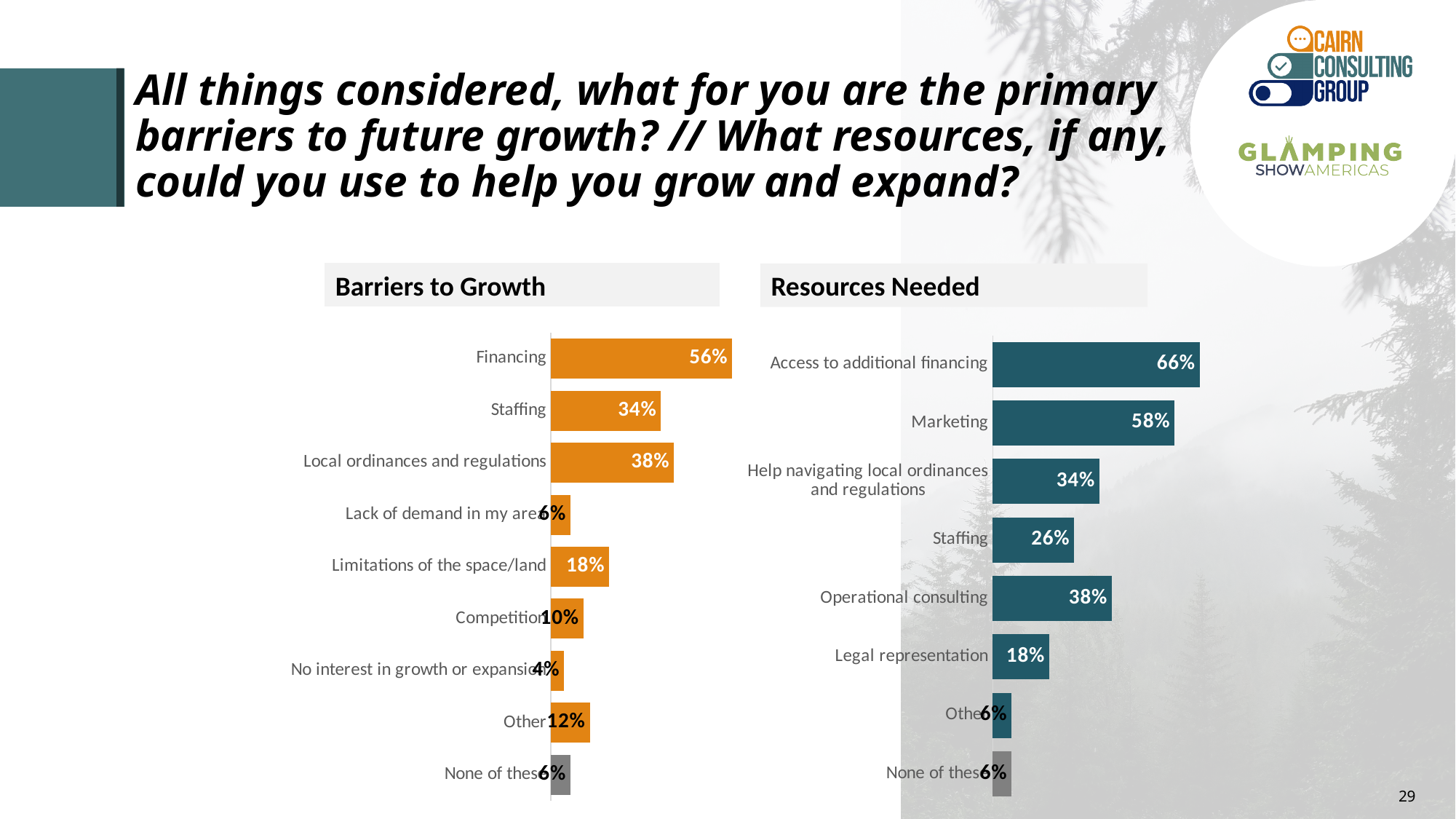
In the Barriers to Growth chart, what percentage is shown for Financing? 56% In the Resources Needed chart, what percentage is shown for Legal representation? 18% In the Barriers to Growth chart, what percentage is shown for Local ordinances and regulations? 38% What type of chart is the Resources Needed chart? Bar chart In the Barriers to Growth chart, which category has the highest value? Financing In the Resources Needed chart, what is the difference between Access to additional financing and Operational consulting? 28% In the Resources Needed chart, what percentage is shown for Marketing? 58% In the Resources Needed chart, which category has the highest value? Access to additional financing How many categories are shown in the Barriers to Growth chart? 9 In the Resources Needed chart, which is larger, Staffing or Operational consulting? Operational consulting In the Barriers to Growth chart, which category has the lowest value? No interest in growth or expansion In the Barriers to Growth chart, what is the difference between Financing and Staffing? 22%